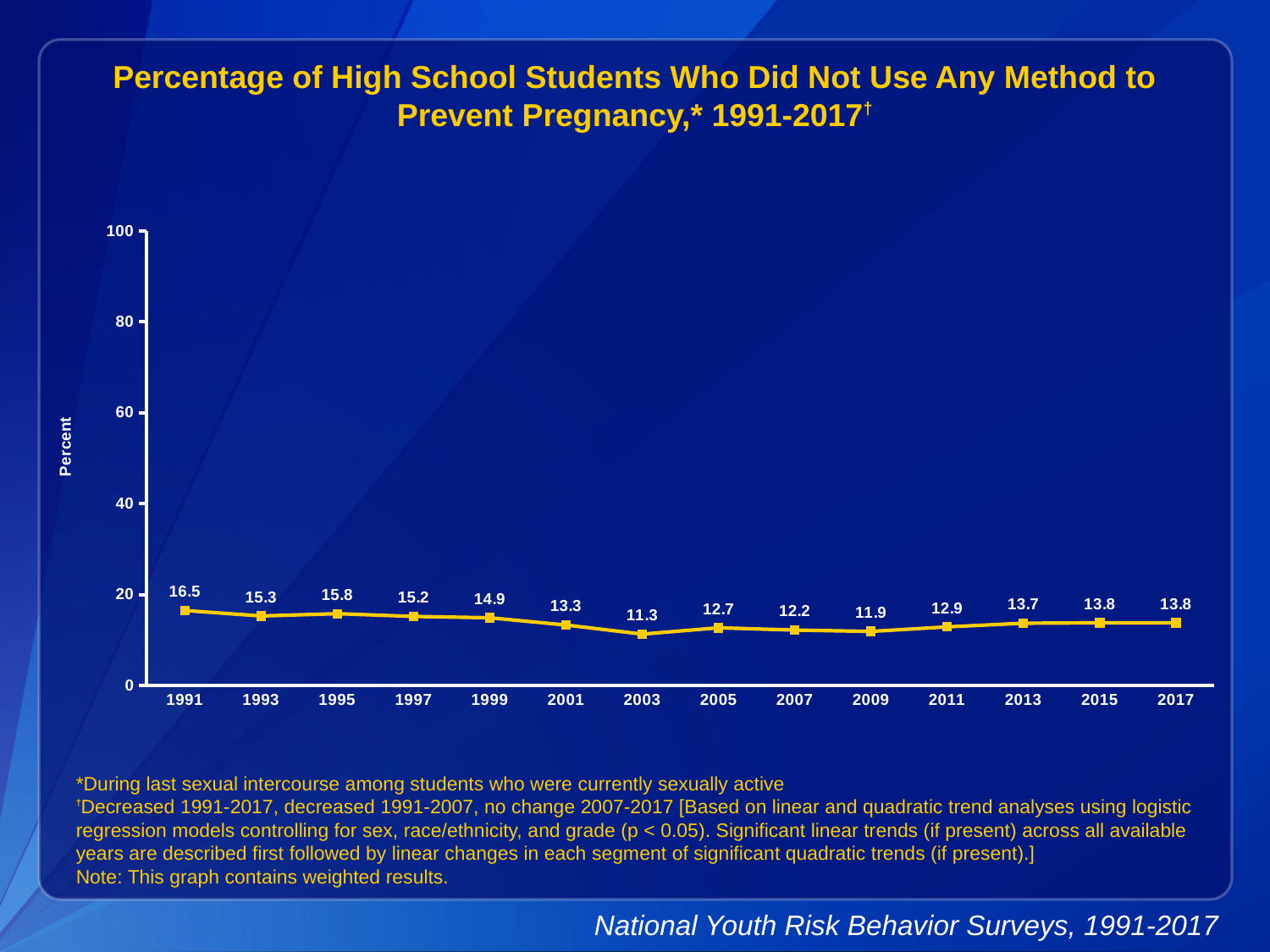
Is the value for 2001 greater or less than 20? less What is the difference between the values for 1991 and 2017? 2.7 What is the difference between the values for 1995 and 2003? 4.5 How many years are plotted on the x axis? 14 Which year has a larger value, 1999 or 2009? 1999 What was the percentage of high school students who did not use any method to prevent pregnancy in 1991? 16.5 What value is shown for 2017? 13.8 What value is shown for 2003? 11.3 Which year has the lowest value on the chart? 2003 What kind of chart is shown on the slide? Line chart What is the label of the y axis? Percent Which year has the highest value on the chart? 1991